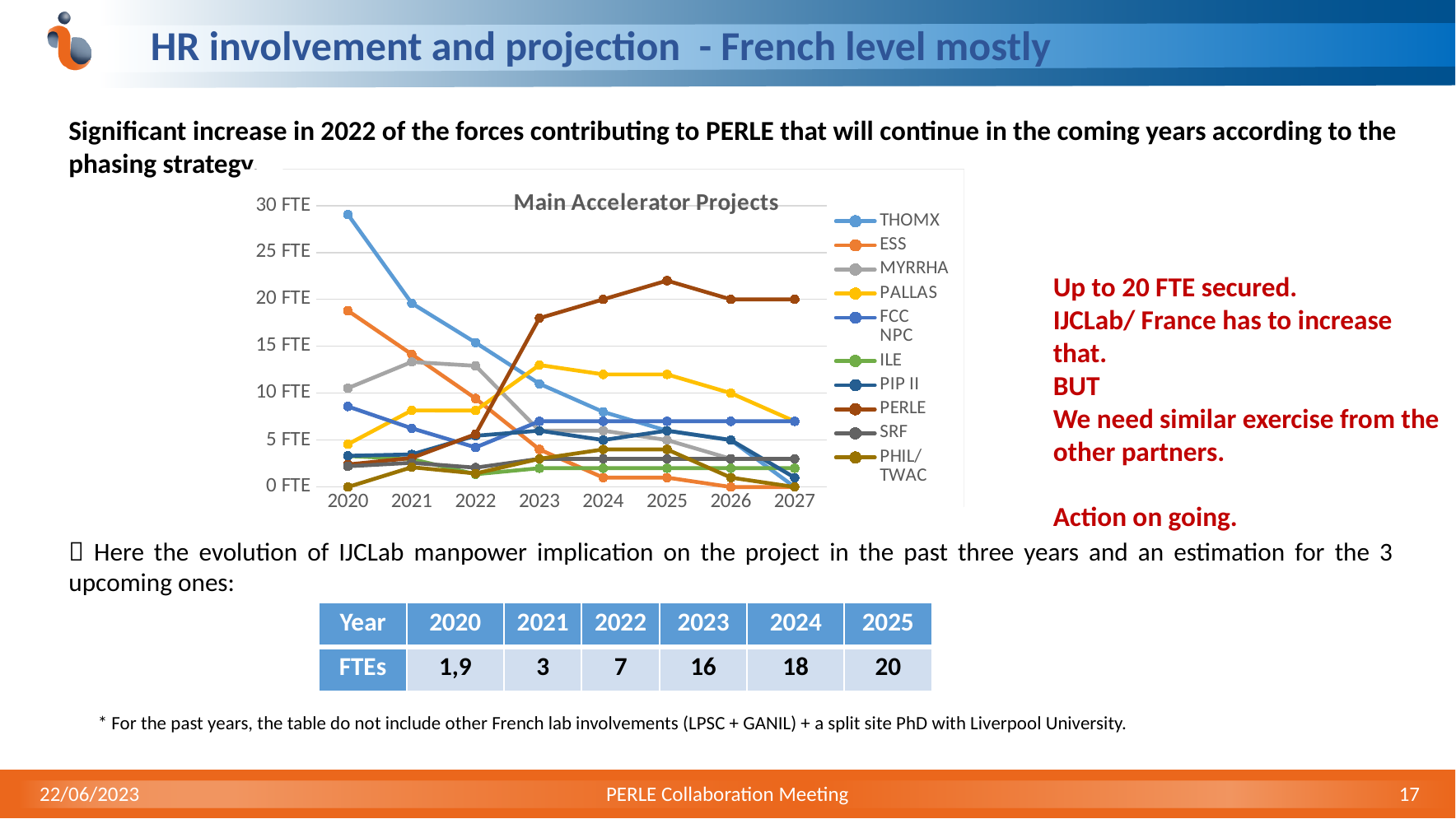
Is the value for THOMX in 2027 greater or less than 5 FTE? less What is the title of the chart? Main Accelerator Projects In 2024, which is larger: the value for PERLE or the value for PALLAS? PERLE Is the value for THOMX in 2020 greater or less than 25 FTE? greater How many series does the chart legend list? 10 Does the THOMX series rise or fall from 2020 to 2027? fall Which series has the highest value in 2025? PERLE How many years are shown along the x axis of the chart? 8 Does the PERLE series rise or fall from 2020 to 2025? rise Is the value for PERLE in 2025 greater or less than 20 FTE? greater Which series has the highest value in 2020? THOMX What kind of chart is shown on the slide? line chart